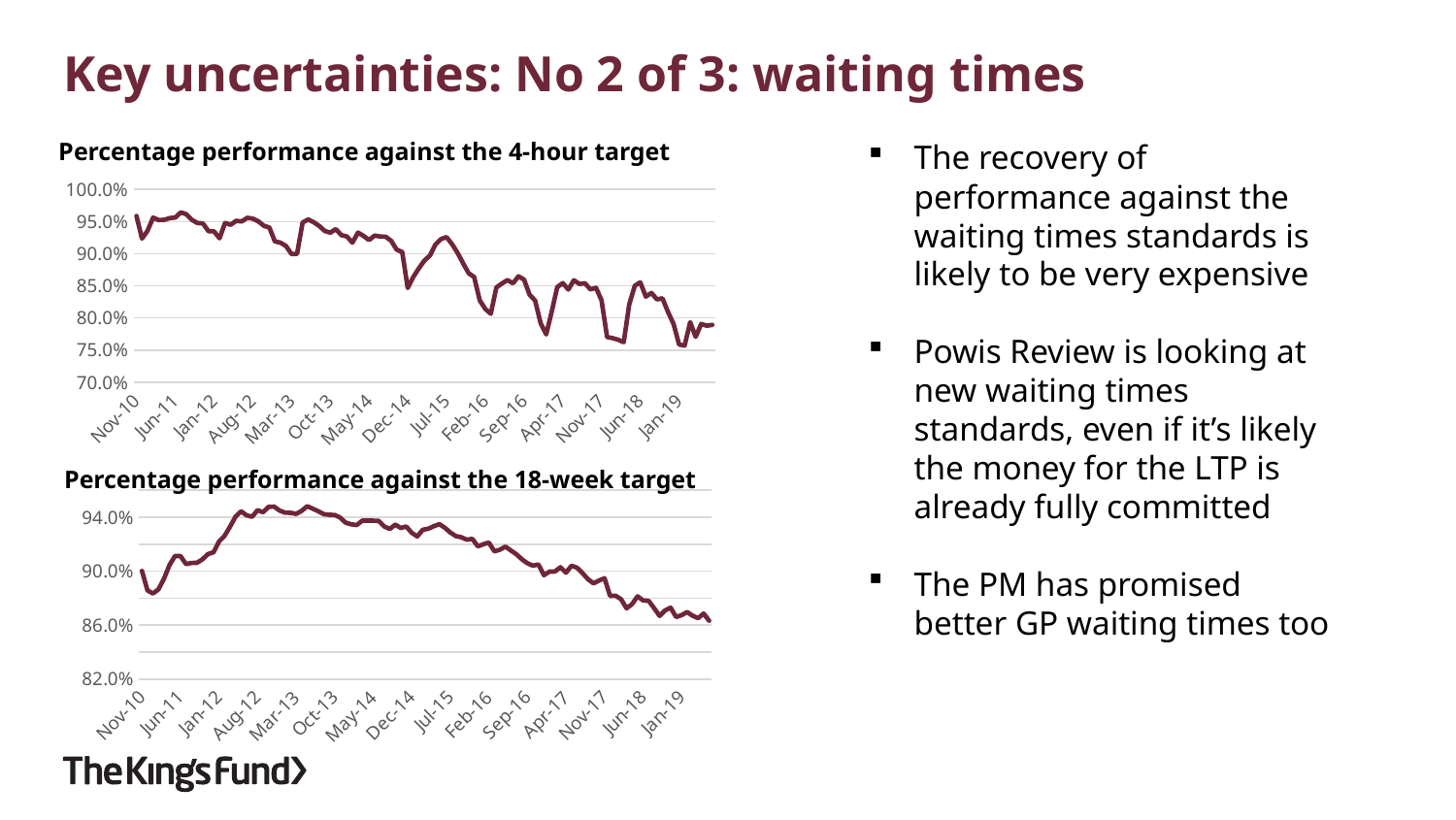
In the 'Percentage performance against the 18-week target' chart, which is higher: the value at Mar-13 or the value at Jan-19? Mar-13 What kind of chart is the 'Percentage performance against the 4-hour target' chart? line chart In the 'Percentage performance against the 18-week target' chart, is the value at Aug-12 greater or less than 90.0%? greater How many date labels are shown on the x axis of the 'Percentage performance against the 4-hour target' chart? 15 In the 'Percentage performance against the 4-hour target' chart, is the value at Jan-19 greater or less than 85.0%? less In the 'Percentage performance against the 4-hour target' chart, which is higher: the value at Nov-10 or the value at Jan-19? Nov-10 What kind of chart is the 'Percentage performance against the 18-week target' chart? line chart In the 'Percentage performance against the 18-week target' chart, is the value at Jan-19 greater or less than 90.0%? less What is the lowest value shown on the y axis of the 'Percentage performance against the 18-week target' chart? 82.0% In the 'Percentage performance against the 4-hour target' chart, do values overall rise or fall from Nov-10 to Jan-19? fall In the 'Percentage performance against the 18-week target' chart, do values overall rise or fall from Aug-12 to Jan-19? fall